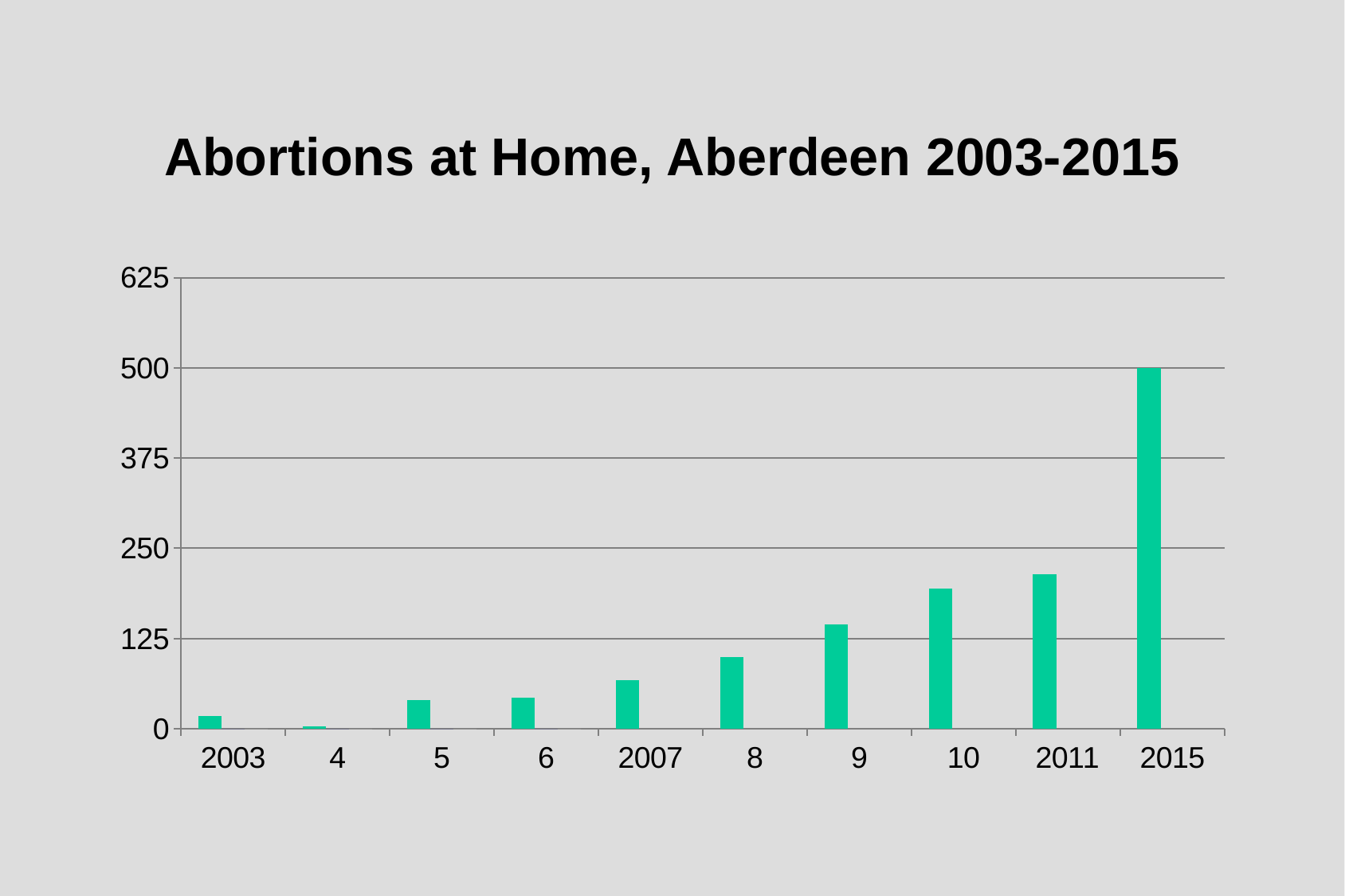
How many bars (categories) are plotted in the chart? 10 Which category has the highest value? 2015 Which category has the lowest value? 4 Is the value for 2007 greater or less than 125? less Which is larger, the value for 9 or the value for 2007? 9 What is the title of the chart? Abortions at Home, Aberdeen 2003-2015 What is the value for 2015? 500 Is the value for 10 greater or less than 125? greater Do the values generally rise or fall from left to right along the x axis? rise Is the value for 2011 greater or less than 250? less What kind of chart is shown on the slide? bar chart